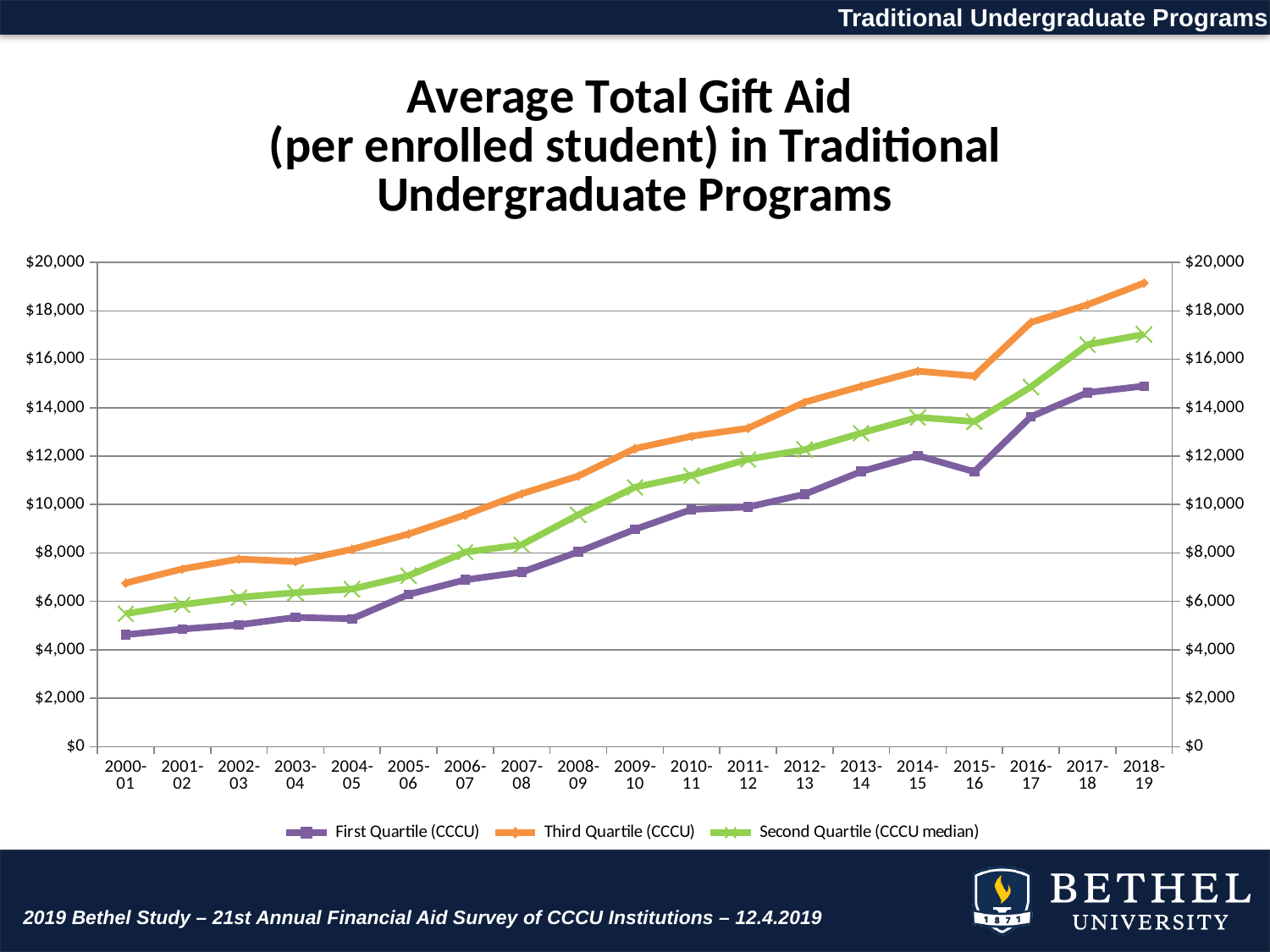
Is the Second Quartile (CCCU median) value for 2014-15 greater or less than $12,000? greater How many academic years are plotted along the x axis? 19 How many series does the legend list? 3 Is the First Quartile (CCCU) value for 2000-01 greater or less than $6,000? less What kind of chart is shown on the slide? Line chart Does the Third Quartile (CCCU) series generally rise or fall from 2000-01 to 2018-19? Rise Is the Third Quartile (CCCU) value for 2000-01 greater or less than $8,000? less Which series has the highest value in 2018-19? Third Quartile (CCCU) In which year is the First Quartile (CCCU) value lowest? 2000-01 What colour is the line for the Third Quartile (CCCU) series? Orange For the First Quartile (CCCU) series, which is larger: the value for 2014-15 or the value for 2015-16? 2014-15